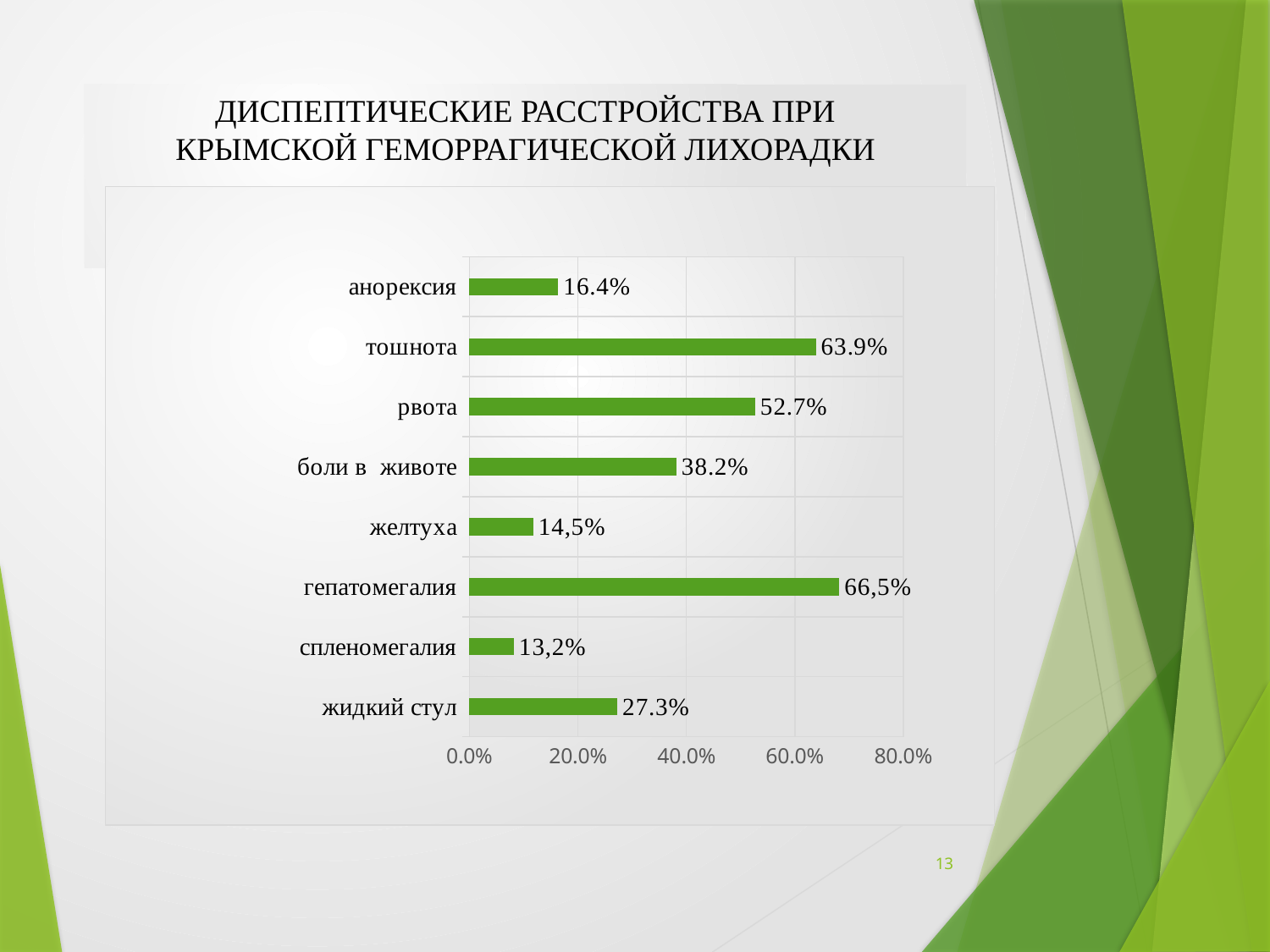
Which is larger, the value for рвота or the value for боли в животе? рвота Which category has the highest value? гепатомегалия What is the difference between the values for боли в животе and анорексия? 21.8% Is the value for рвота greater or less than 40.0%? greater How many categories are shown in the chart? 8 What is the value for жидкий стул? 27.3% What is the difference between the values for тошнота and рвота? 11.2% What kind of chart is shown on the slide? bar chart What is the value for тошнота? 63.9% What is the value for спленомегалия? 13,2% Which category has the lowest value? спленомегалия What is the value for гепатомегалия? 66,5%